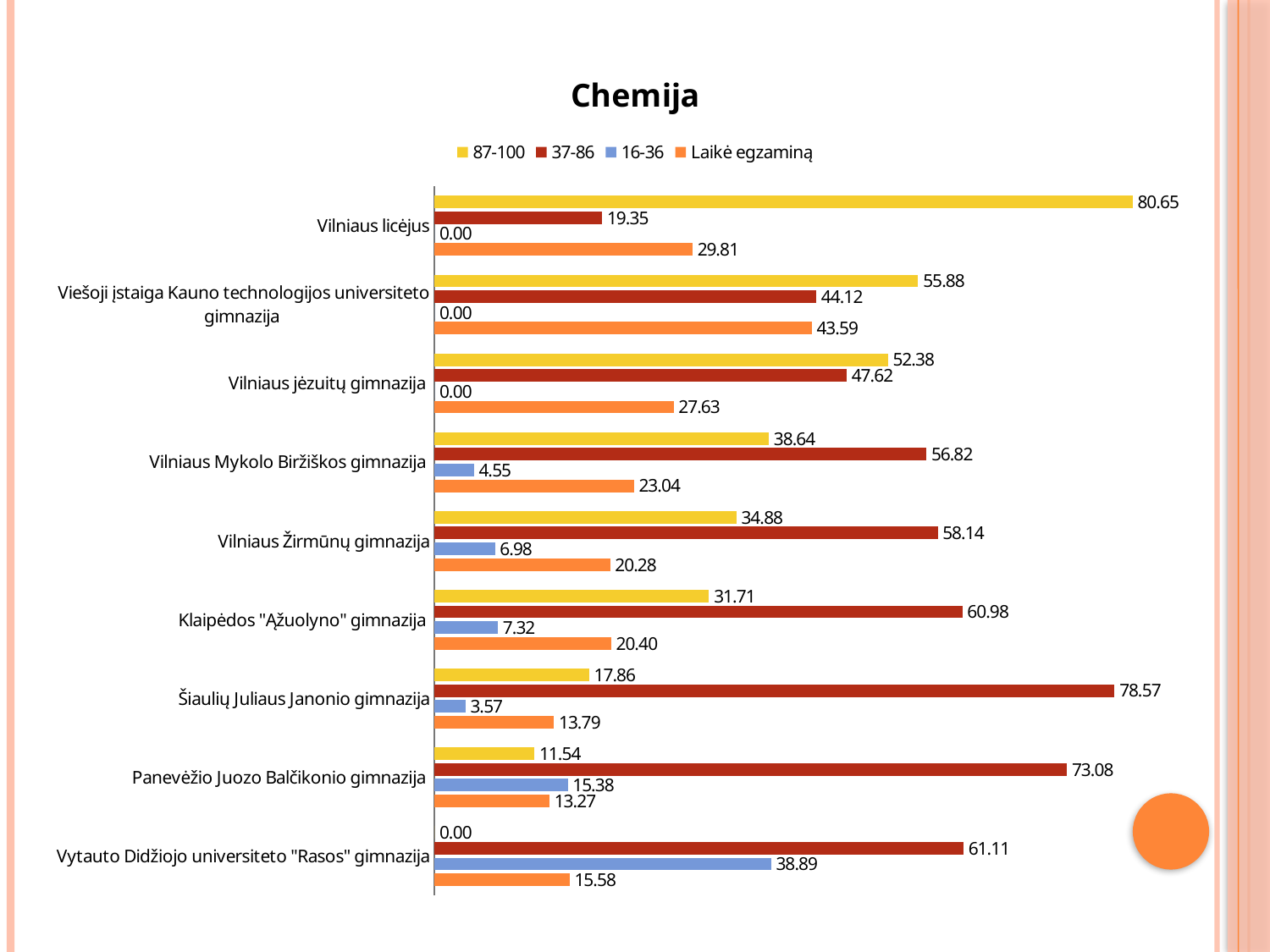
Which school has the highest value in the 87-100 series? Vilniaus licėjus What is the value of the 37-86 series for Šiaulių Juliaus Janonio gimnazija? 78.57 What is the Laikė egzaminą value for Viešoji įstaiga Kauno technologijos universiteto gimnazija? 43.59 What is the title of the chart? Chemija How many series does the legend list? 4 What is the value of the 16-36 series for Vytauto Didžiojo universiteto "Rasos" gimnazija? 38.89 How many schools are shown on the chart? 9 What is the value of the 87-100 series for Vilniaus licėjus? 80.65 What type of chart is shown on the slide? Bar chart Which school has the lowest Laikė egzaminą value? Panevėžio Juozo Balčikonio gimnazija Which is larger for Klaipėdos "Ąžuolyno" gimnazija: the 87-100 value or the 37-86 value? 37-86 What is the difference between the 37-86 and 87-100 values for Vilniaus jėzuitų gimnazija? 4.76